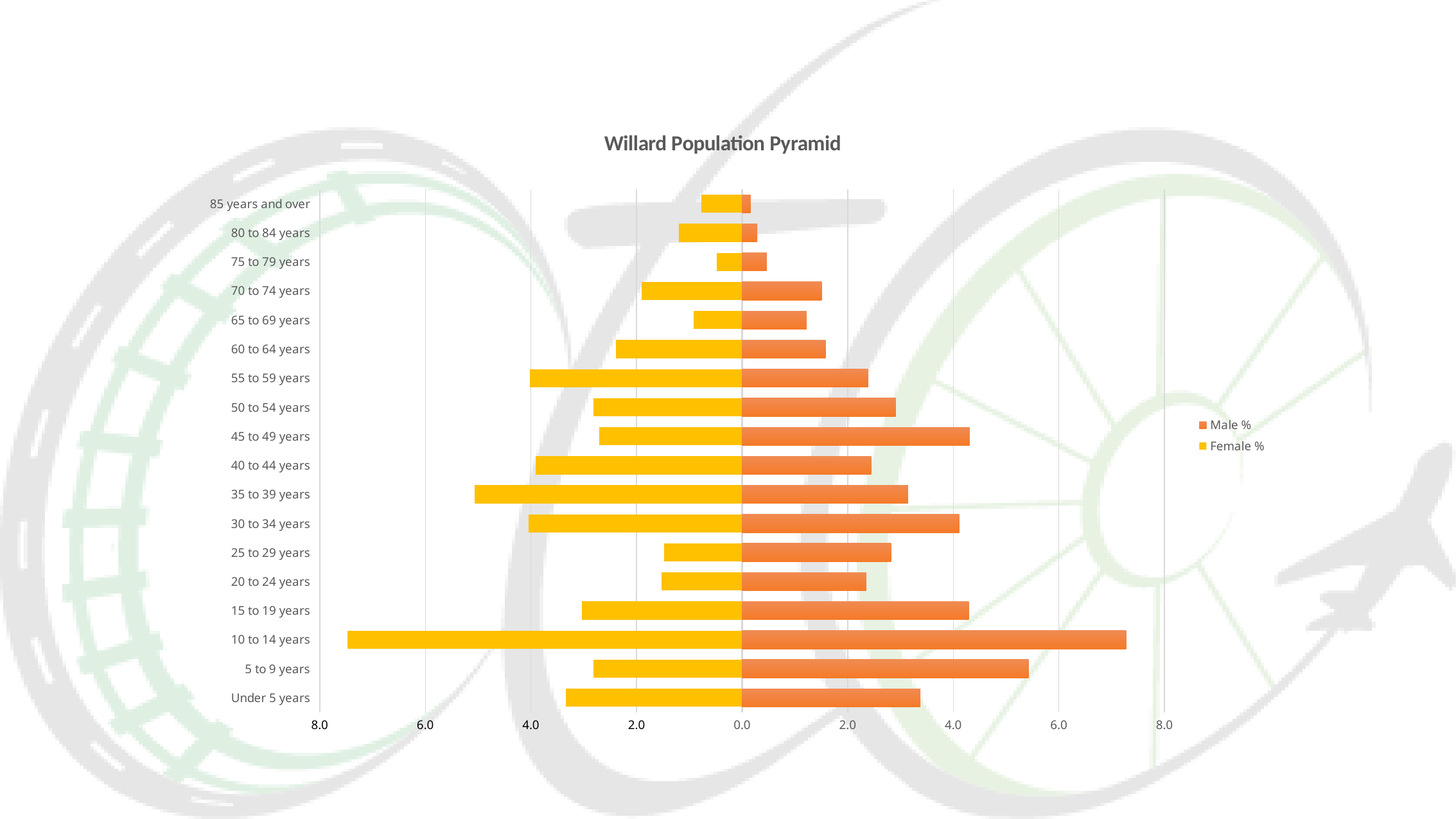
How many series does the legend list? 2 How many age-group categories are plotted on the chart? 18 Which age group has the highest Female % value? 10 to 14 years Which is larger, the Male % for 10 to 14 years or the Male % for 5 to 9 years? 10 to 14 years What kind of chart is shown on the slide? bar chart For the 45 to 49 years age group, which is larger, Male % or Female %? Male % Which age group has the highest Male % value? 10 to 14 years Which age group has the lowest Male % value? 85 years and over What is the title of the chart? Willard Population Pyramid Is the Female % value for 35 to 39 years greater or less than 4.0? greater Is the Female % value for 25 to 29 years greater or less than 2.0? less Is the Male % value for 10 to 14 years greater or less than 6.0? greater